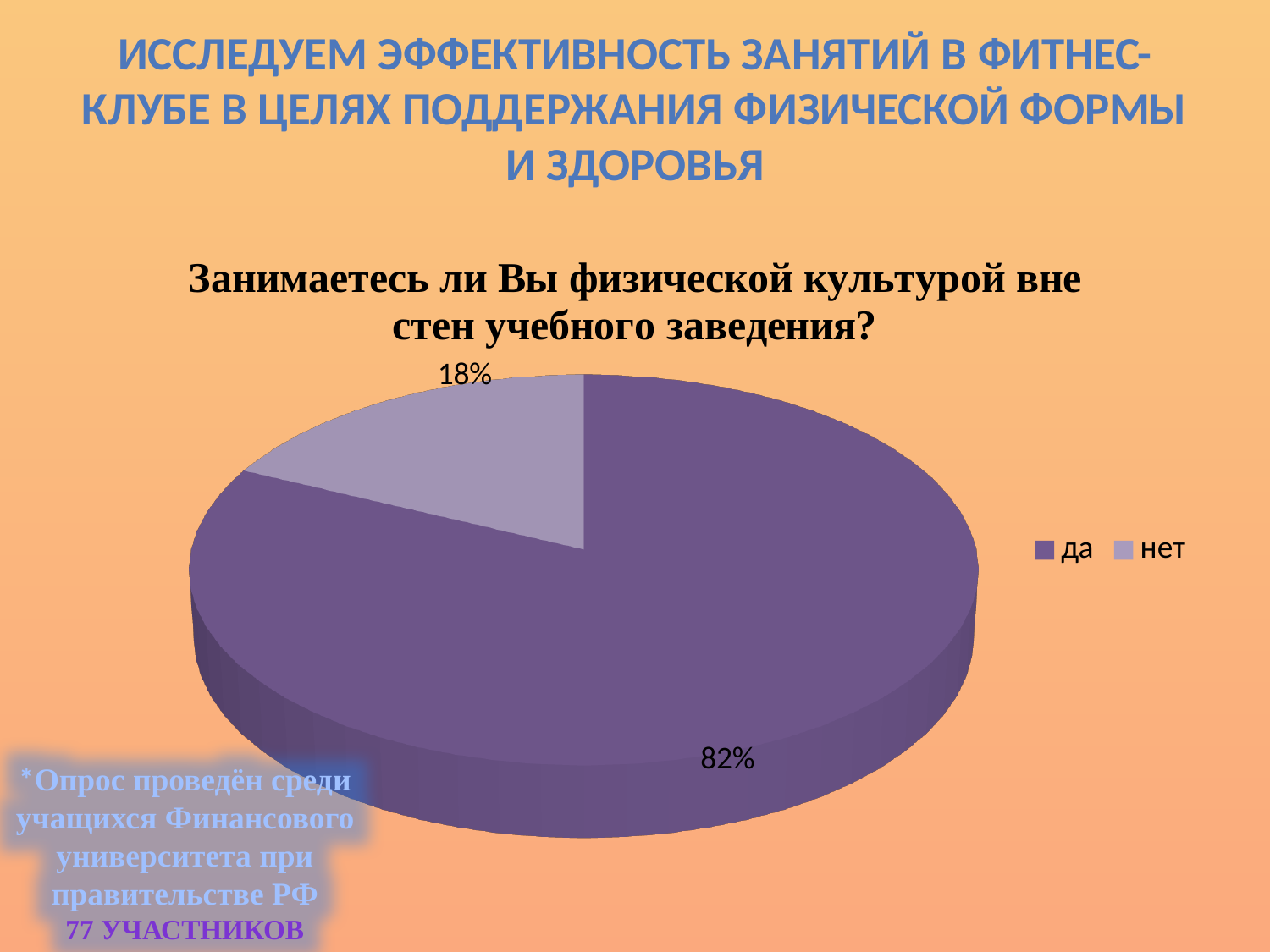
What kind of chart is shown on the slide? pie chart Which is larger, the "да" slice or the "нет" slice? да What share of the pie does the "да" slice represent? 82% What share of the pie does the "нет" slice represent? 18% What is the difference in percentage points between the "да" and "нет" slices? 64 What are the two legend entries of the chart? да, нет How many categories does the pie chart show? 2 Which category has the largest slice of the pie? да What is the total of the two slices shown in the pie chart? 100% What is the title of the chart? Занимаетесь ли Вы физической культурой вне стен учебного заведения? Which category has the smallest slice of the pie? нет